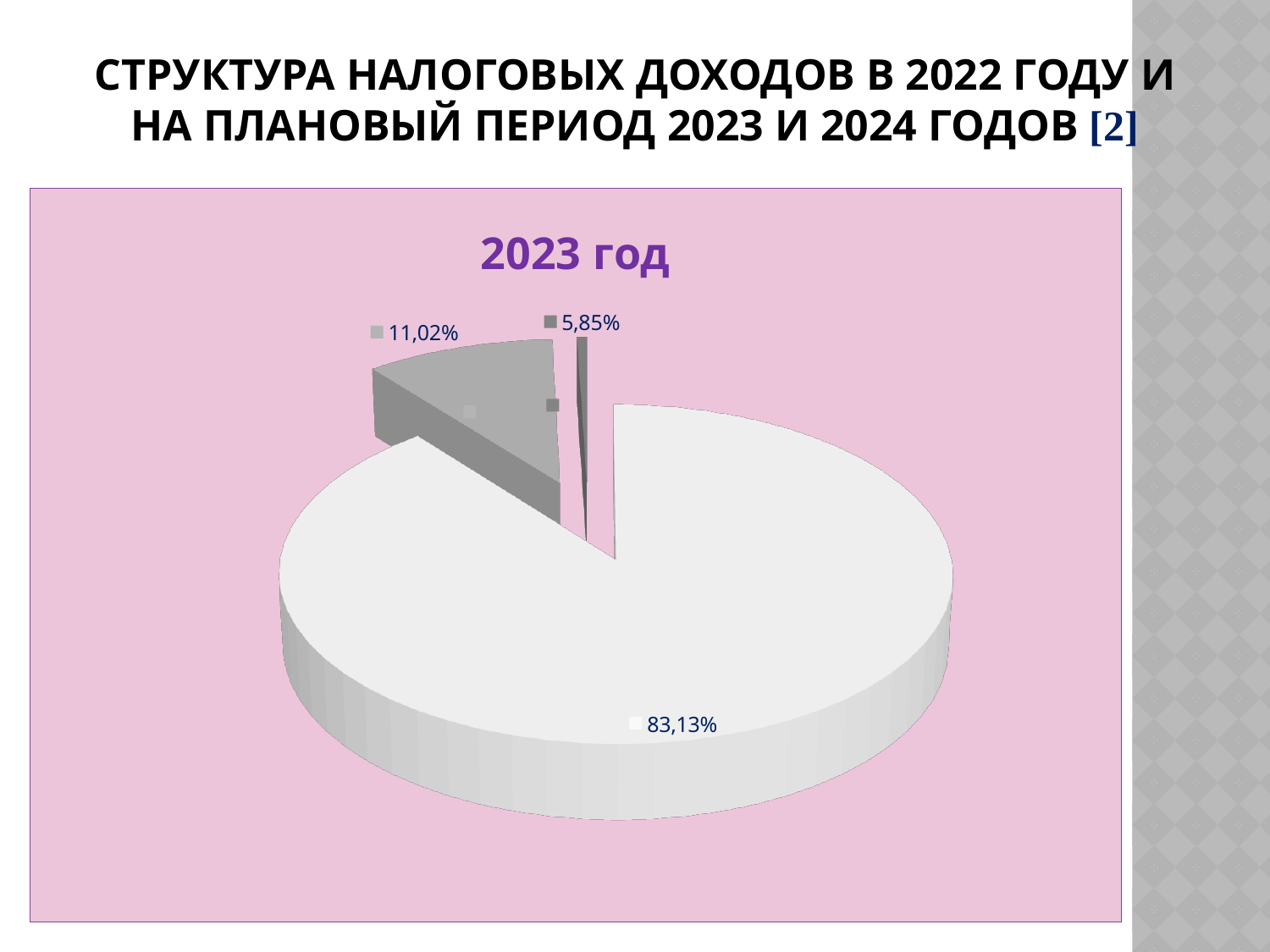
Is the largest slice of the pie chart greater or less than 50%? greater What kind of chart is shown on the slide? pie chart What is the value of the smallest slice of the pie chart? 5,85% What is the value of the grey slice labelled between the largest and smallest slices? 11,02% What is the title of the chart? 2023 год What is the difference between the largest slice (83,13%) and the smallest slice (5,85%)? 77,28% Which slice is larger: the one labelled 11,02% or the one labelled 5,85%? 11,02% What colour is the largest slice of the pie chart? white What is the sum of the three percentage labels shown on the pie chart? 100% How many slices does the pie chart have? 3 What is the value of the largest slice of the pie chart? 83,13% What is the difference between the 11,02% slice and the 5,85% slice? 5,17%